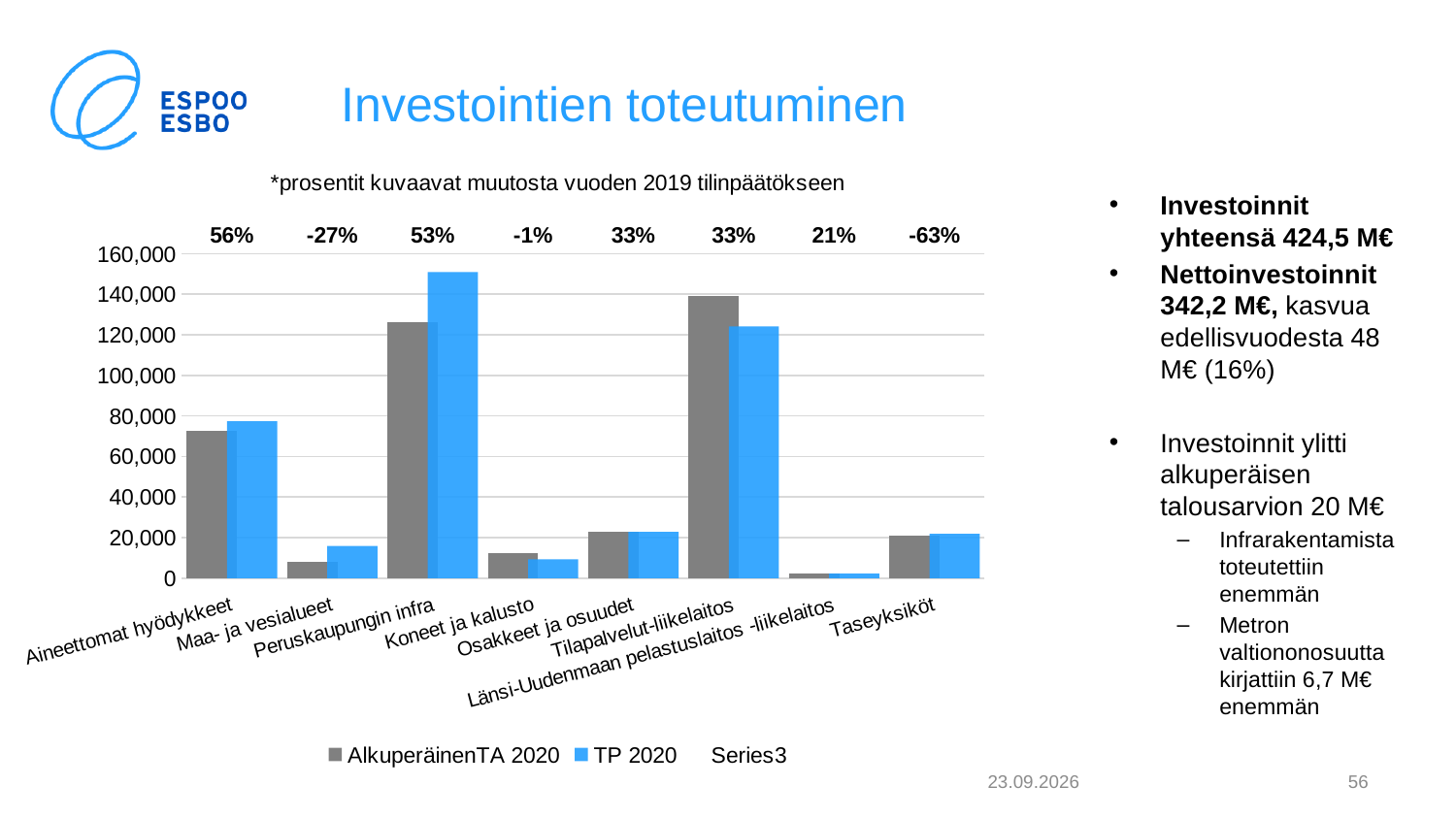
Which category has the highest TP 2020 bar? Peruskaupungin infra How many series does the chart legend list? 3 What percentage change is printed above the Aineettomat hyödykkeet category? 56% Is the AlkuperäinenTA 2020 value for Maa- ja vesialueet greater or less than 20,000? less Which series is shown in blue in the chart legend? TP 2020 For Koneet ja kalusto, which is larger: the AlkuperäinenTA 2020 bar or the TP 2020 bar? AlkuperäinenTA 2020 What percentage change is printed above the Koneet ja kalusto category? -1% Which category has the lowest TP 2020 bar? Länsi-Uudenmaan pelastuslaitos -liikelaitos How many categories are shown on the x axis of the chart? 8 What type of chart is shown on the slide? bar chart What percentage change is printed above the Taseyksiköt category? -63% Is the TP 2020 value for Peruskaupungin infra greater or less than 140,000? greater